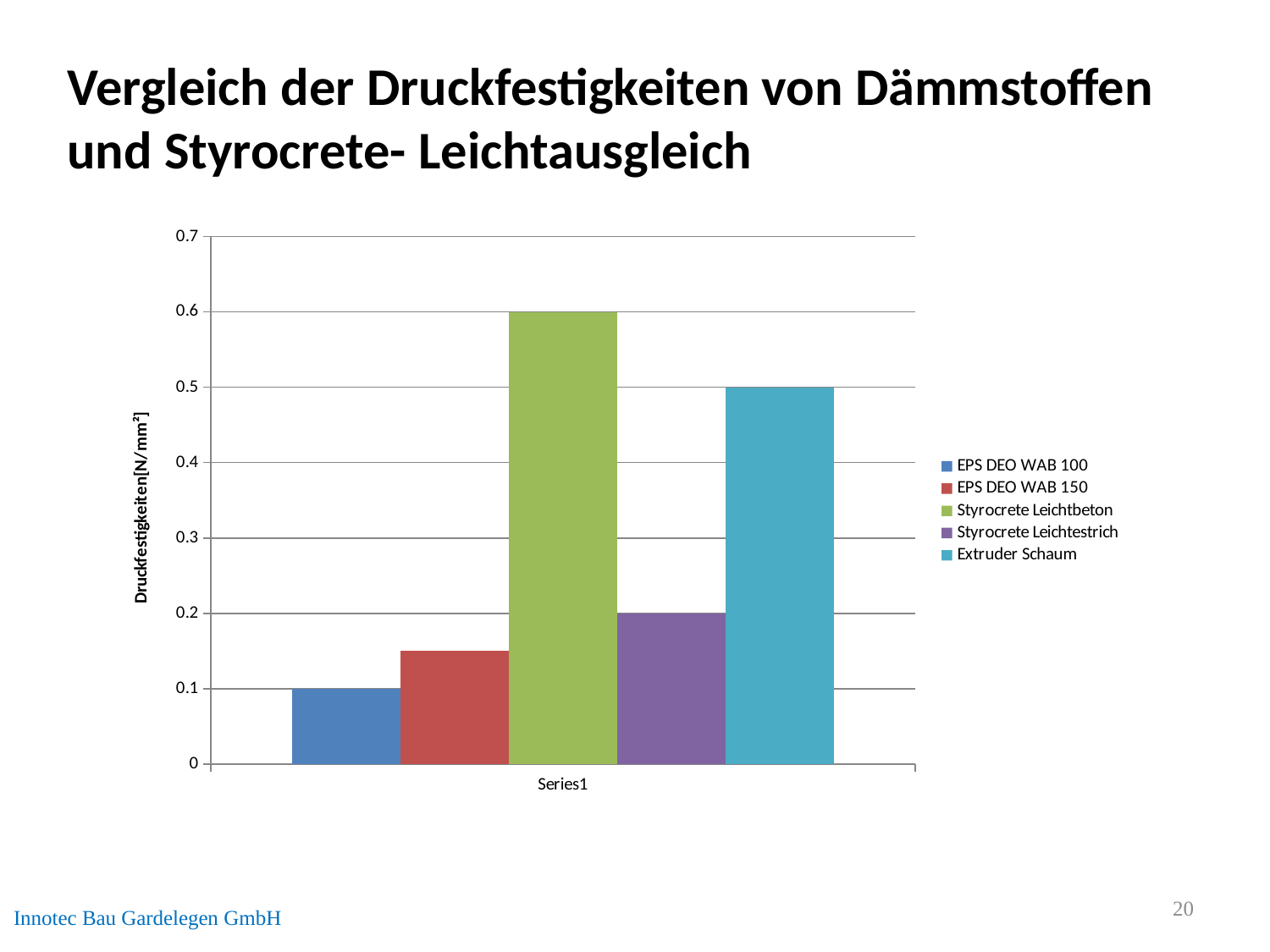
Which series has the highest value? Styrocrete Leichtbeton What is the value for Styrocrete Leichtbeton? 0.6 What is the label of the vertical axis? Druckfestigkeiten[N/mm²] Which is larger, the value for Extruder Schaum or the value for Styrocrete Leichtestrich? Extruder Schaum What is the value for Styrocrete Leichtestrich? 0.2 What is the value for Extruder Schaum? 0.5 How many series does the legend list? 5 What kind of chart is shown on the slide? bar chart What is the difference between the values for Styrocrete Leichtbeton and Extruder Schaum? 0.1 Which series has the lowest value? EPS DEO WAB 100 What is the value for EPS DEO WAB 100? 0.1 Is the value for EPS DEO WAB 150 greater or less than 0.2? less